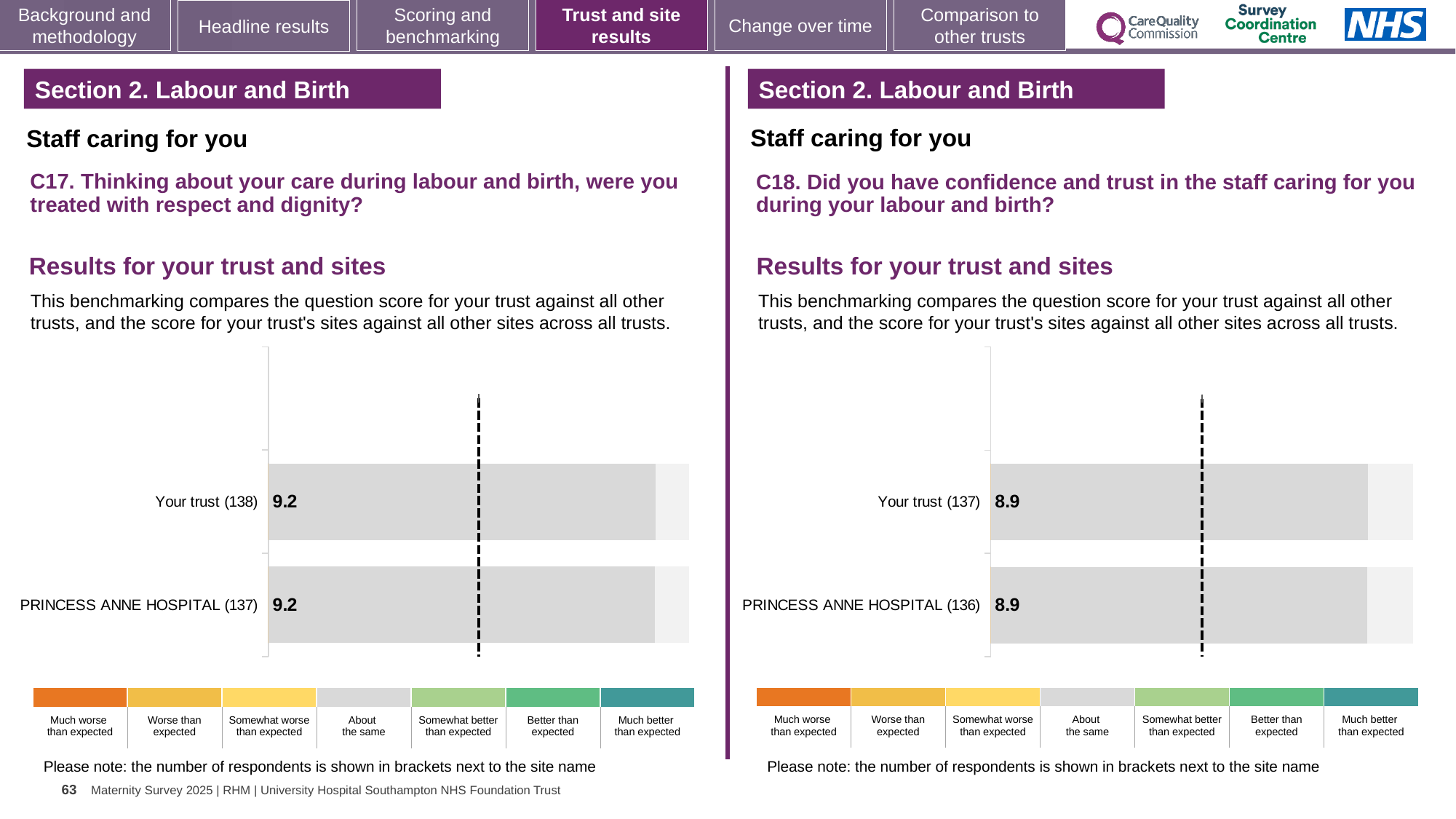
What kind of chart is used for the C17 results on the left? Bar chart How many bars are plotted in the C17 chart on the left? 2 In the C18 chart on the right, what is the score for Your trust? 8.9 In the C17 chart on the left, how many respondents are shown in brackets for PRINCESS ANNE HOSPITAL? 137 In the C18 chart on the right, what is the difference between the Your trust score and the PRINCESS ANNE HOSPITAL score? 0 How many bars are plotted in the C18 chart on the right? 2 In the C17 chart on the left, what is the difference between the Your trust score and the PRINCESS ANNE HOSPITAL score? 0 In the C18 chart on the right, what is the score for PRINCESS ANNE HOSPITAL? 8.9 In the C17 chart on the left, what is the score for PRINCESS ANNE HOSPITAL? 9.2 In the C18 chart on the right, how many respondents are shown in brackets for Your trust? 137 In the C17 chart on the left, what is the score for Your trust? 9.2